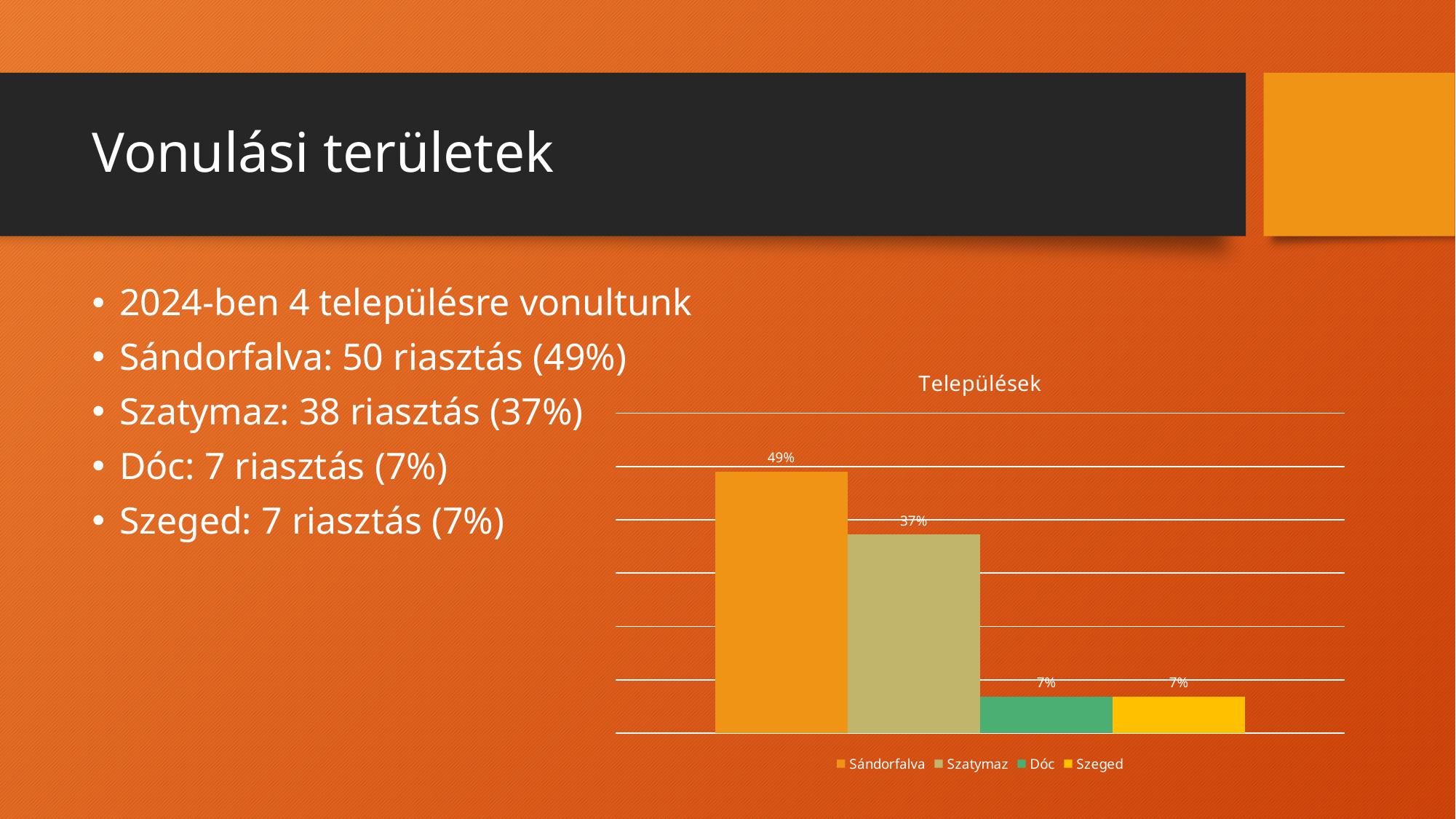
What is the value shown for Sándorfalva in the chart? 49% What is the difference between the values for Sándorfalva and Szatymaz? 12% Which category has the highest value in the chart? Sándorfalva How many bars are plotted in the chart? 4 What is the value shown for Szatymaz in the chart? 37% What is the value shown for Szeged in the chart? 7% Which is larger, the value for Sándorfalva or the value for Szatymaz? Sándorfalva How many entries does the chart legend list? 4 What type of chart is shown on the slide? Bar chart What is the difference between the values for Szatymaz and Dóc? 30% Which is larger, the value for Szatymaz or the value for Szeged? Szatymaz What is the value shown for Dóc in the chart? 7%